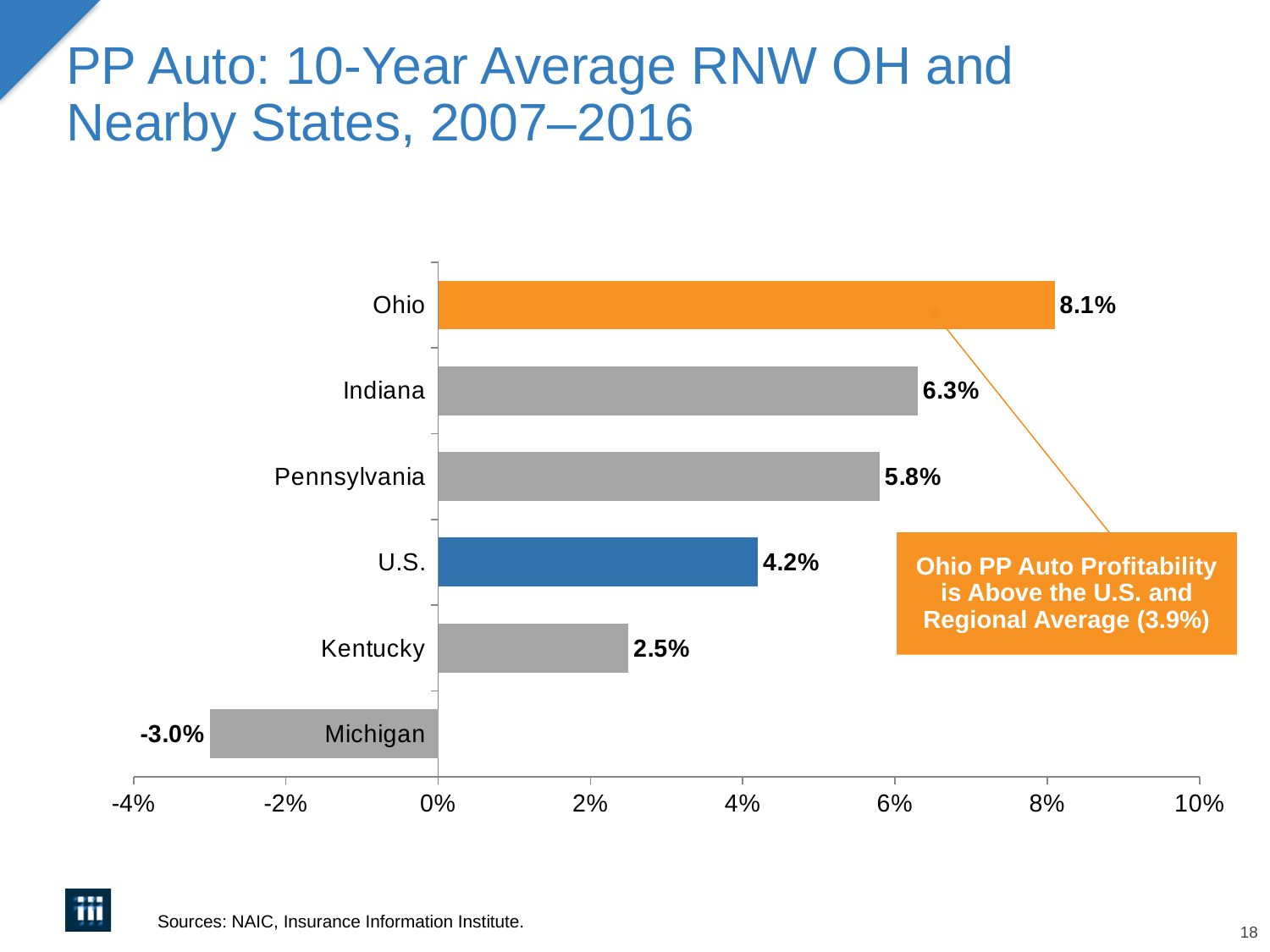
What is the value shown for the U.S.? 4.2% Which is larger, the value for Kentucky or the value for Pennsylvania? Pennsylvania How many categories are plotted in the chart? 6 What is the difference between Indiana's and Pennsylvania's values? 0.5% According to the callout box, what is the regional average? 3.9% What kind of chart is shown on the slide? Bar chart What is the 10-year average RNW for Ohio? 8.1% What is the value shown for Michigan? -3.0% Which category has the lowest value? Michigan Which category has the highest value? Ohio What colour is the bar for Ohio? Orange What is the difference between Ohio's value and the U.S. value? 3.9%